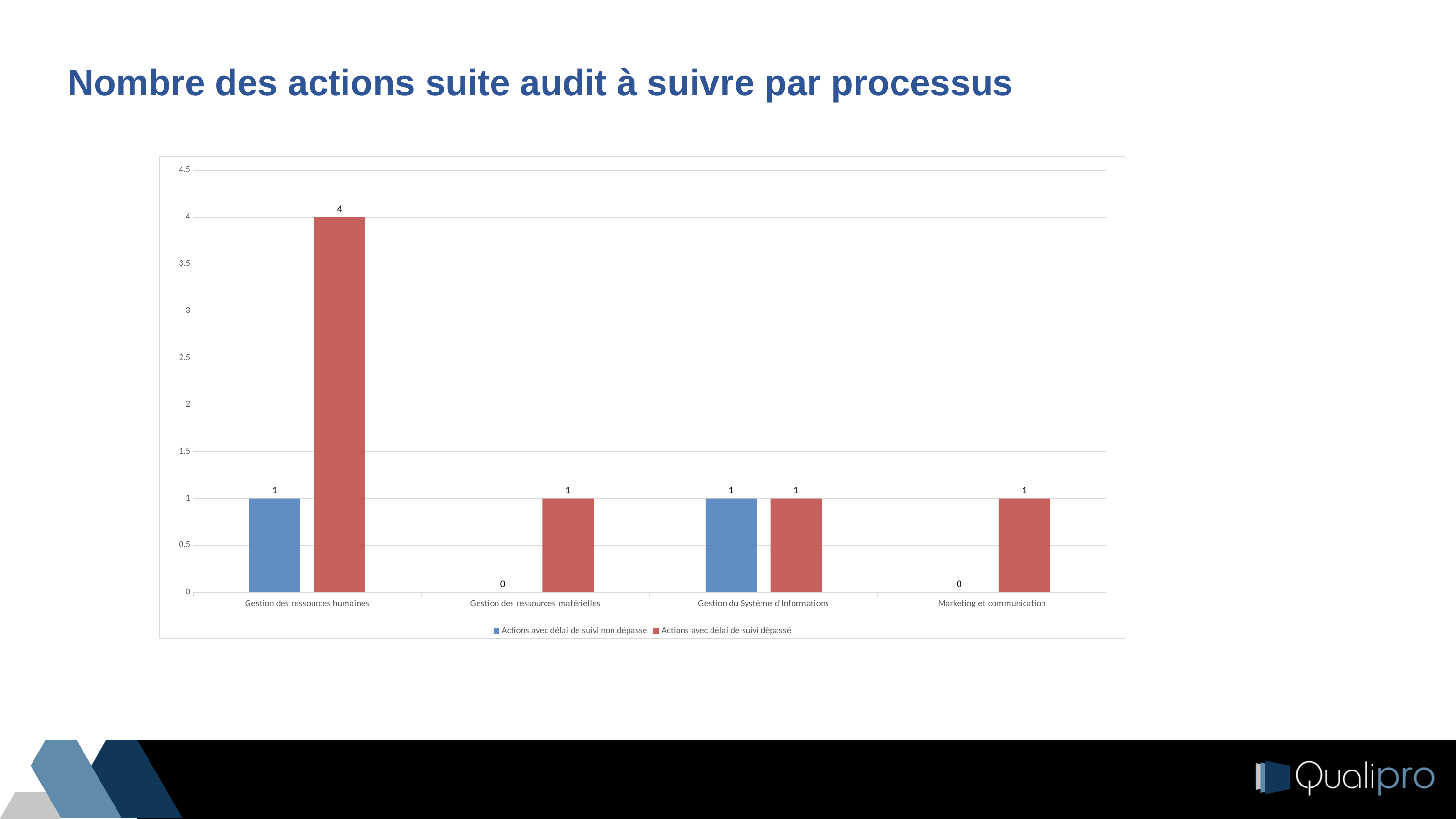
Which colour represents 'Actions avec délai de suivi dépassé' in the legend? Red What is the value of 'Actions avec délai de suivi dépassé' for Gestion des ressources humaines? 4 What kind of chart is shown on the slide? Bar chart What is the title of the slide? Nombre des actions suite audit à suivre par processus What is the value of 'Actions avec délai de suivi non dépassé' for Gestion du Système d'Informations? 1 What is the value of 'Actions avec délai de suivi non dépassé' for Gestion des ressources matérielles? 0 How many series does the legend list? 2 How many processes are shown on the x axis? 4 What is the value of 'Actions avec délai de suivi dépassé' for Marketing et communication? 1 For Gestion des ressources humaines, which series is larger: 'Actions avec délai de suivi non dépassé' or 'Actions avec délai de suivi dépassé'? Actions avec délai de suivi dépassé Which process has the highest value for 'Actions avec délai de suivi dépassé'? Gestion des ressources humaines What is the difference between the two series for Gestion des ressources humaines? 3